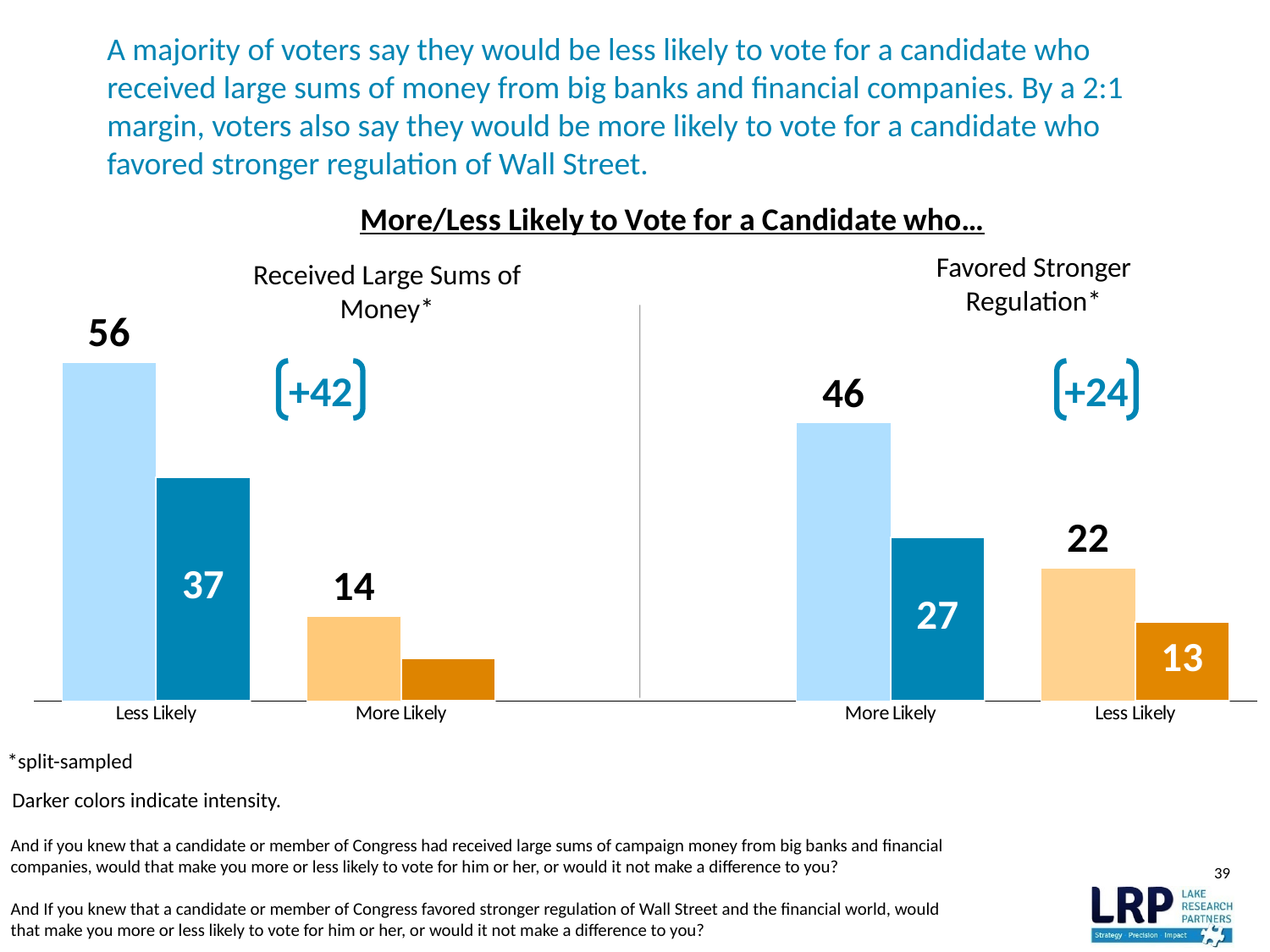
In the 'Received Large Sums of Money' chart, what is the darker (intensity) value shown for Less Likely? 37 In the 'Favored Stronger Regulation' chart, which is larger, More Likely or Less Likely? More Likely In the 'Favored Stronger Regulation' chart, what is the difference between the More Likely value and the Less Likely value? 24 In the 'Received Large Sums of Money' chart, what is the value for Less Likely? 56 In the 'Favored Stronger Regulation' chart, what is the value for Less Likely? 22 In the 'Favored Stronger Regulation' chart, what is the value for More Likely? 46 What net margin is shown in brackets on the 'Favored Stronger Regulation' chart? +24 What kind of chart is used on this slide? Bar chart In the 'Received Large Sums of Money' chart, what is the difference between the Less Likely value and the More Likely value? 42 In the 'Received Large Sums of Money' chart, what is the value for More Likely? 14 In the 'Favored Stronger Regulation' chart, what is the darker (intensity) value shown for Less Likely? 13 In the 'Received Large Sums of Money' chart, which category has the highest value? Less Likely